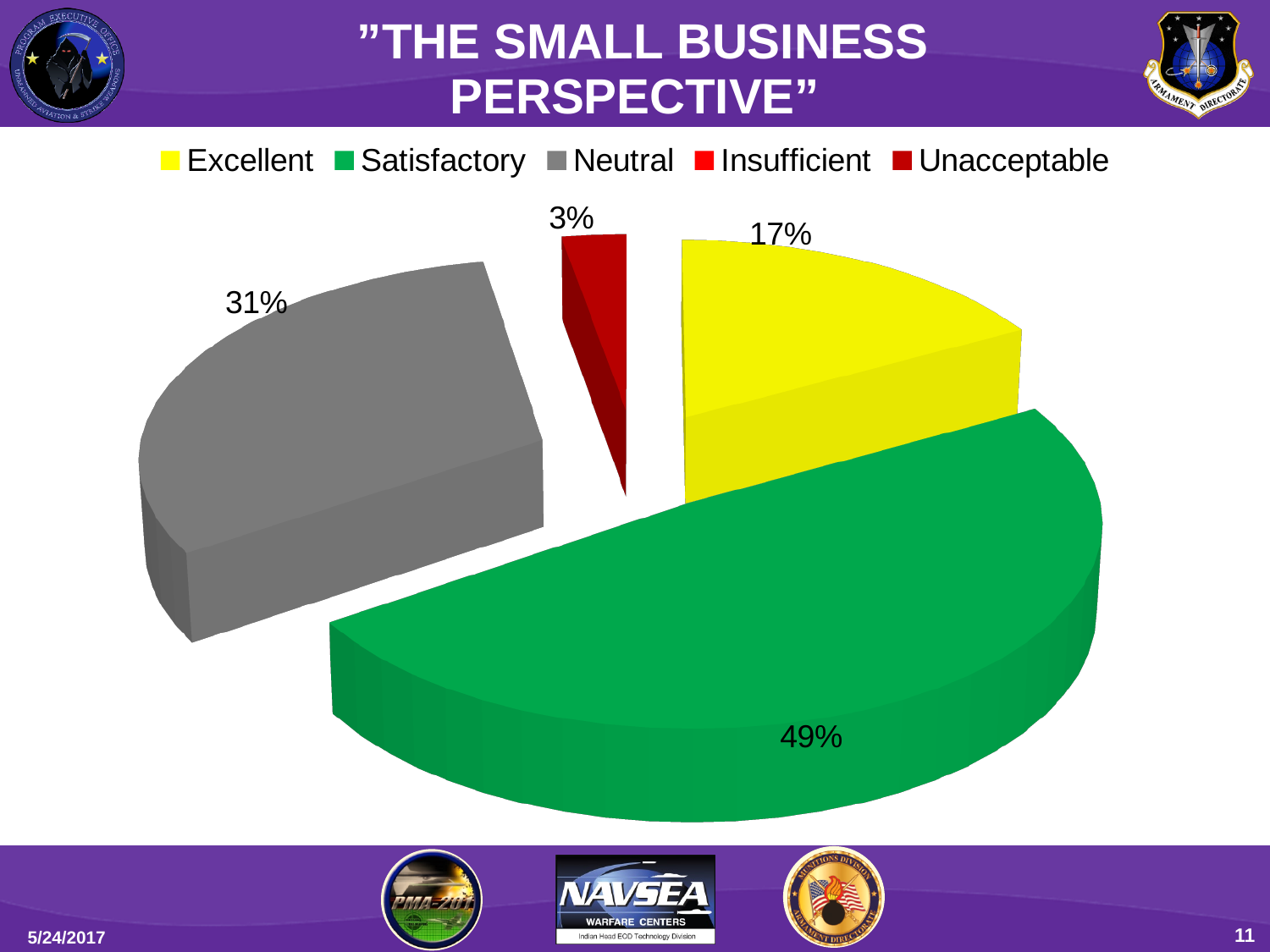
How many slices with percentage labels are shown in the pie? 4 What share of the pie is labelled Neutral? 31% Which category with a visible slice has the smallest share of the pie? Unacceptable What colour is the Neutral slice? gray What share of the pie is labelled Satisfactory? 49% What share of the pie is labelled Unacceptable? 3% What kind of chart is shown on the slide? pie chart Which is larger, the Excellent share or the Neutral share? Neutral How many categories does the legend list? 5 What is the difference between the Satisfactory share and the Neutral share? 18% Which category has the largest slice of the pie? Satisfactory